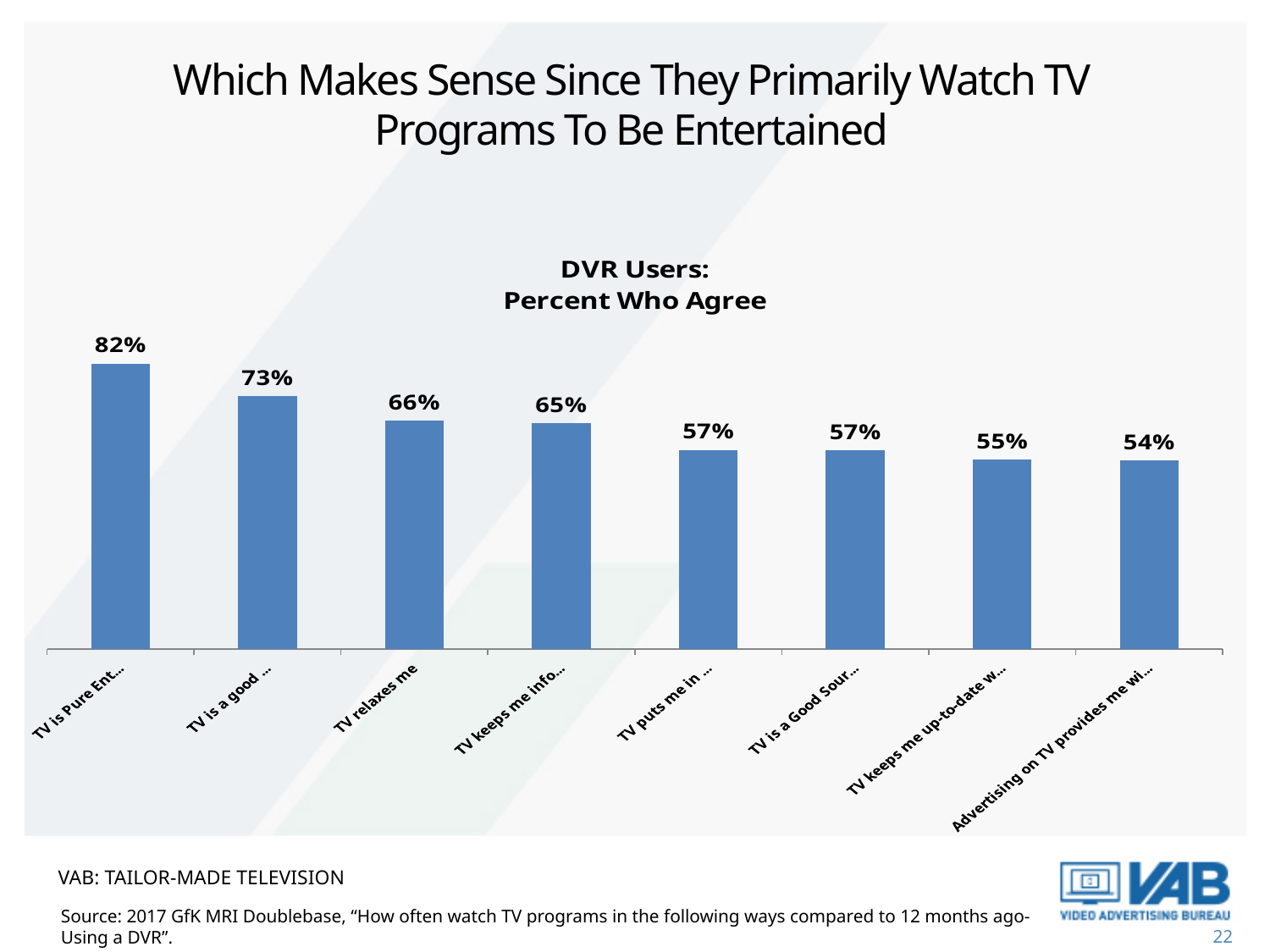
How many bars show a value of 57%? 2 What is the value shown for the fourth bar from the left? 65% What is the highest value shown in the chart? 82% What is the lowest value shown in the chart? 54% Do the values rise or fall moving from left to right across the chart? Fall What type of chart is shown on the slide? Bar chart What is the difference between the first bar (82%) and the last bar (54%)? 28 percentage points Which is larger: the value for "TV relaxes me" or the value for the last (rightmost) bar? TV relaxes me What is the difference between the highest value (82%) and the value for "TV relaxes me"? 16 percentage points What is the value shown for the first (leftmost) bar in the chart? 82% How many bars are shown in the chart? 8 What percentage of DVR users agree that "TV relaxes me"? 66%